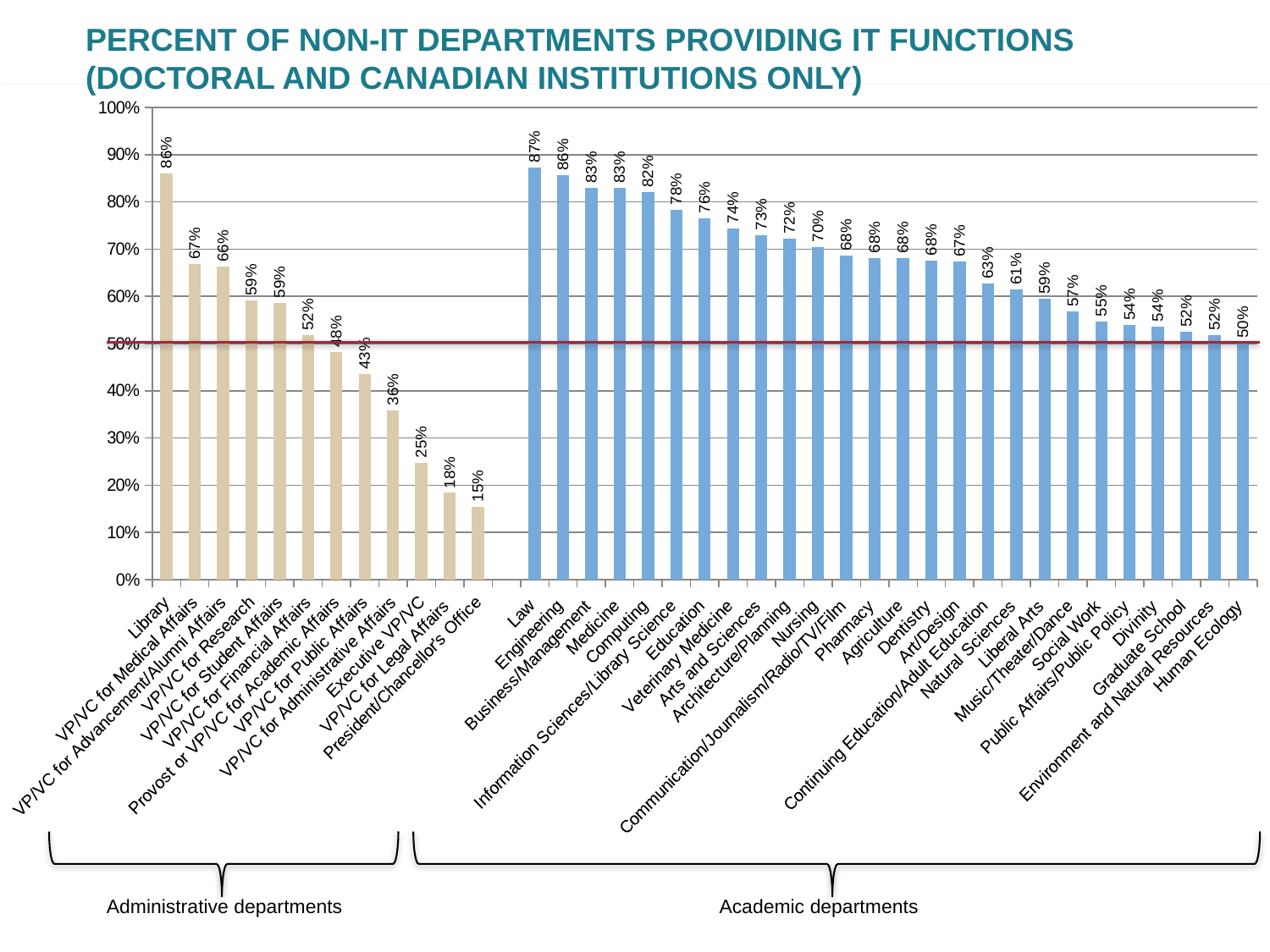
Which department has the highest percentage on the chart? Law What is the title of the chart? Percent of Non-IT Departments Providing IT Functions (Doctoral and Canadian Institutions Only) How many administrative departments are shown on the chart? 12 What kind of chart is shown on the slide? Bar chart What percentage is shown for Law? 87% What percentage is shown for the President/Chancellor's Office? 15% Which department has the lowest percentage on the chart? President/Chancellor's Office Which has a higher percentage, Executive VP/VC or VP/VC for Administrative Affairs? VP/VC for Administrative Affairs What percentage is shown for Nursing? 70% Which has a higher percentage, VP/VC for Research or Liberal Arts? They are equal (59%) What is the difference between the percentages for Engineering and Human Ecology? 36% What percentage is shown for the Library? 86%